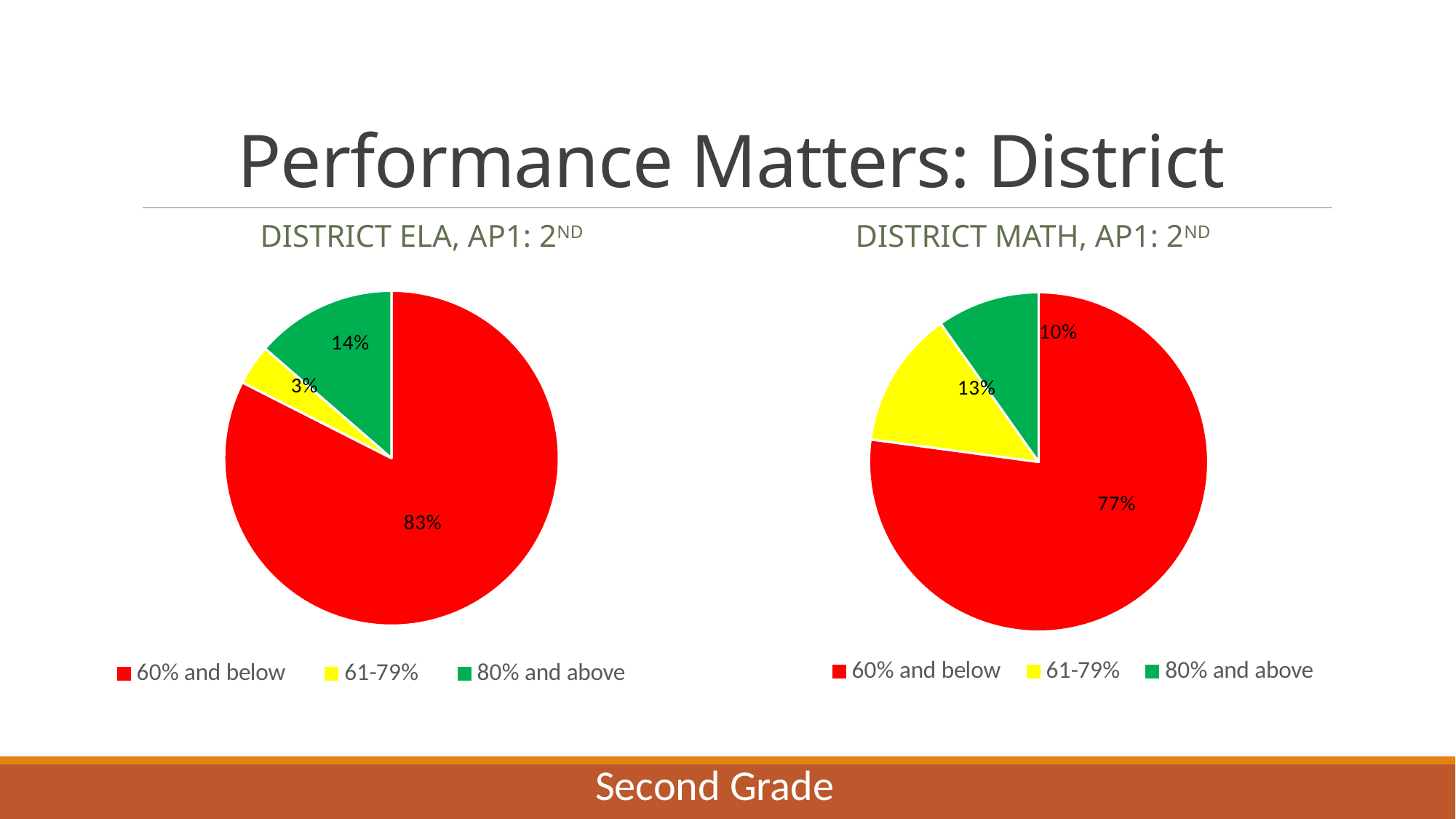
What is the difference between the 60% and below values in the DISTRICT ELA, AP1: 2ND chart and the DISTRICT MATH, AP1: 2ND chart? 6% In the DISTRICT MATH, AP1: 2ND chart, which category has the largest slice? 60% and below In the DISTRICT MATH, AP1: 2ND chart, what is the value for the 61-79% category? 13% In the DISTRICT ELA, AP1: 2ND chart, what is the value for the 61-79% category? 3% In the DISTRICT MATH, AP1: 2ND chart, what is the value for the 60% and below category? 77% In the DISTRICT ELA, AP1: 2ND chart, what is the value for the 80% and above category? 14% In the DISTRICT MATH, AP1: 2ND chart, what is the value for the 80% and above category? 10% What kind of chart is the DISTRICT ELA, AP1: 2ND chart? Pie chart In the DISTRICT ELA, AP1: 2ND chart, what share of the pie is labelled for the 60% and below category? 83% In the DISTRICT ELA, AP1: 2ND chart, which category has the smallest slice? 61-79% Is the 61-79% slice larger in the DISTRICT ELA, AP1: 2ND chart or the DISTRICT MATH, AP1: 2ND chart? DISTRICT MATH, AP1: 2ND How many categories does the legend of the DISTRICT MATH, AP1: 2ND chart list? 3